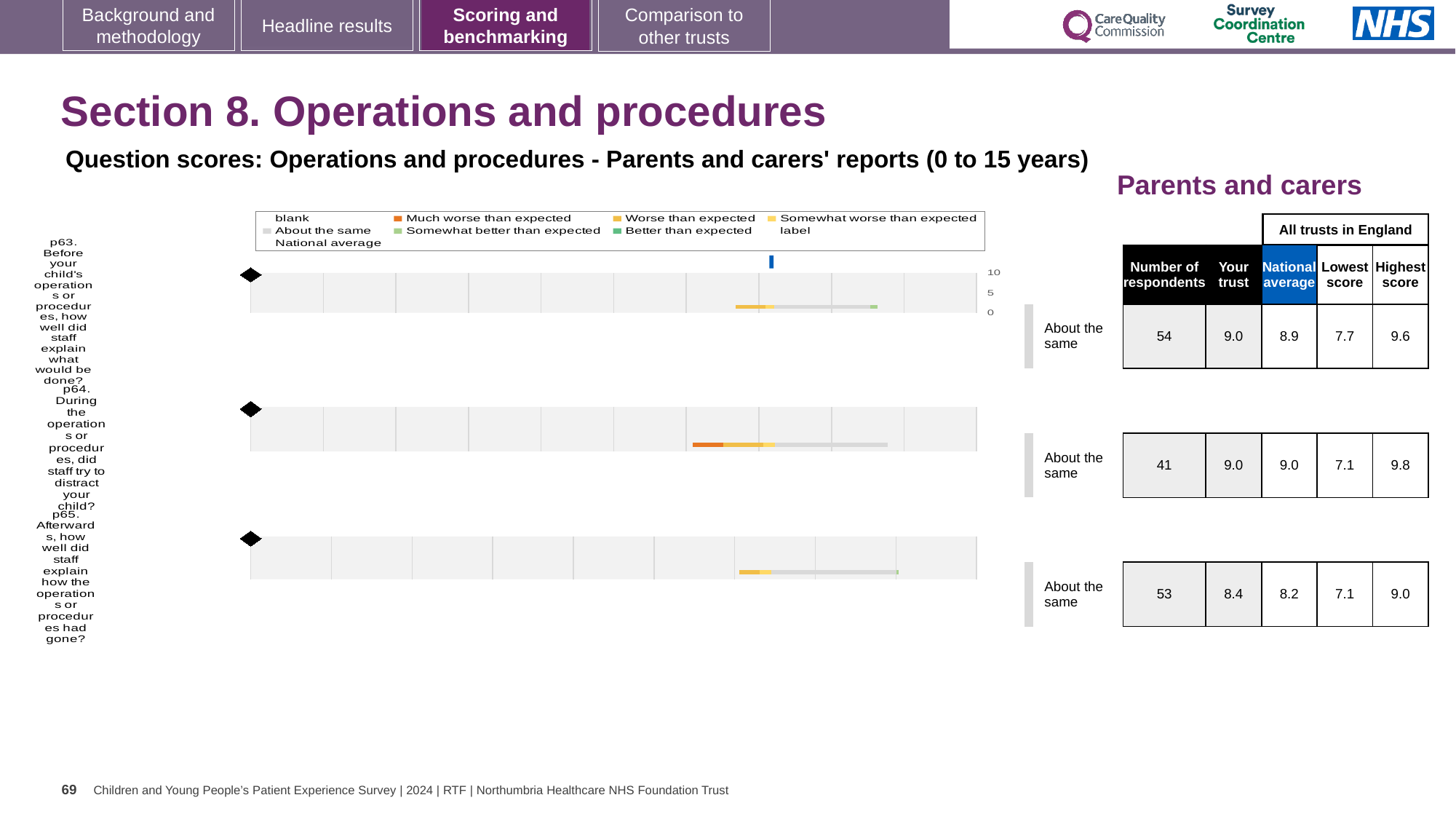
What kind of chart is used to show the question scores for p63, p64 and p65? bar chart Which question has the lowest 'Your trust' score? p65 How many respondents answered p64 (did staff try to distract your child during the operation)? 41 Which question has the highest 'Highest score' across all trusts in England? p64 How many questions (p63, p64, p65) are plotted on the slide? 3 For p64, what is the difference between the 'Your trust' score and the lowest score across all trusts? 1.9 What colour represents 'Much worse than expected' in the chart legend? orange For p65, which is larger: the 'Your trust' score or the national average? Your trust What is the national average score for p65 (how well staff explained how the operations or procedures had gone)? 8.2 What is the 'Your trust' score for p63 (how well staff explained what would be done before the operation)? 9.0 What benchmark category is shown next to each of the three question charts? About the same For p63, what is the difference between the highest score (9.6) and the lowest score (7.7) across all trusts? 1.9